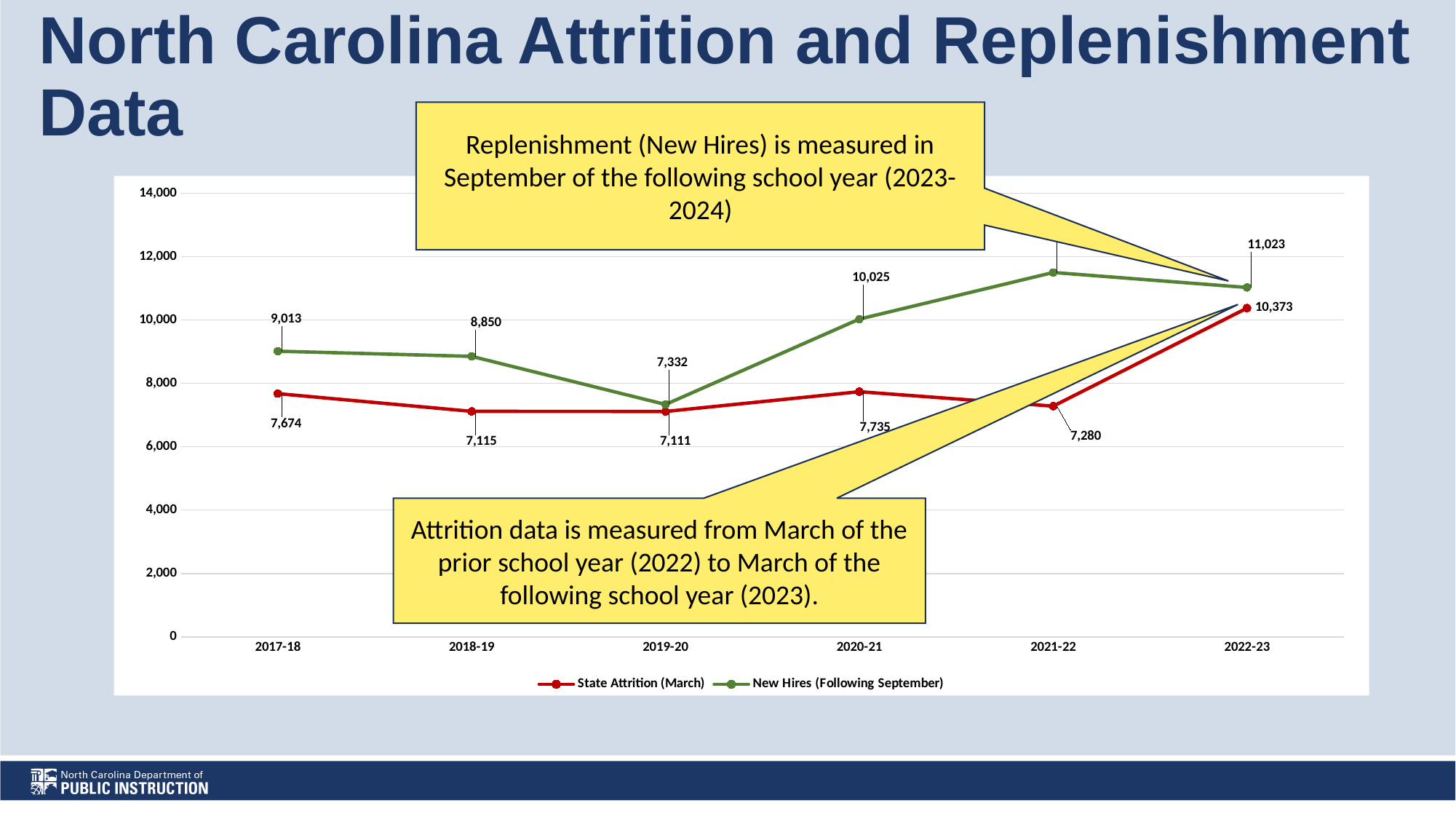
What is the difference between New Hires (Following September) and State Attrition (March) in 2022-23? 650 What kind of chart is shown on the slide? Line chart In which school year is State Attrition (March) highest? 2022-23 By how much did State Attrition (March) increase from 2021-22 to 2022-23? 3,093 What is the New Hires (Following September) value for 2020-21? 10,025 In which school year is New Hires (Following September) lowest? 2019-20 What is the State Attrition (March) value for 2017-18? 7,674 Which is larger in 2017-18: State Attrition (March) or New Hires (Following September)? New Hires (Following September) What is the State Attrition (March) value for 2022-23? 10,373 How many school years are shown on the x axis? 6 Is the New Hires (Following September) value for 2021-22 greater or less than 10,000? greater What is the New Hires (Following September) value for 2019-20? 7,332